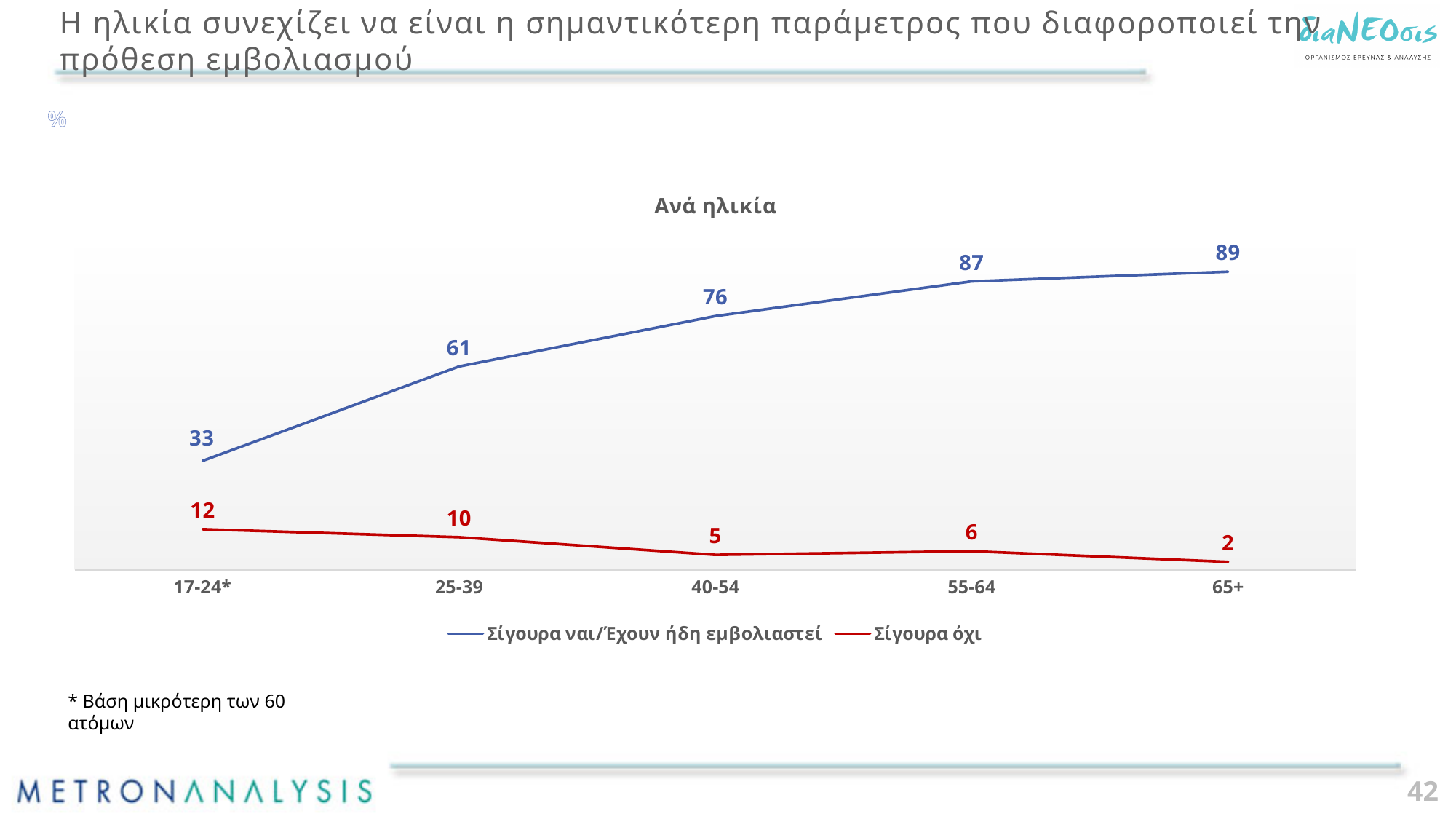
Which age group has the highest value in the 'Σίγουρα ναι/Έχουν ήδη εμβολιαστεί' series? 65+ Which age group has the lowest value in the 'Σίγουρα όχι' series? 65+ Do the values of the 'Σίγουρα ναι/Έχουν ήδη εμβολιαστεί' series rise or fall from 17-24* to 65+? Rise What is the difference between the 'Σίγουρα ναι/Έχουν ήδη εμβολιαστεί' values for 65+ and 17-24*? 56 What is the value for the 40-54 age group in the 'Σίγουρα όχι' series? 5 What is the title of the chart? Ανά ηλικία What kind of chart is shown on the slide? Line chart Which is larger in the 'Σίγουρα όχι' series: the value for 17-24* or the value for 55-64? 17-24* What is the value for the 25-39 age group in the 'Σίγουρα ναι/Έχουν ήδη εμβολιαστεί' series? 61 How many series does the legend list? 2 What is the value for the 65+ age group in the 'Σίγουρα ναι/Έχουν ήδη εμβολιαστεί' series? 89 How many age groups are shown on the x axis? 5